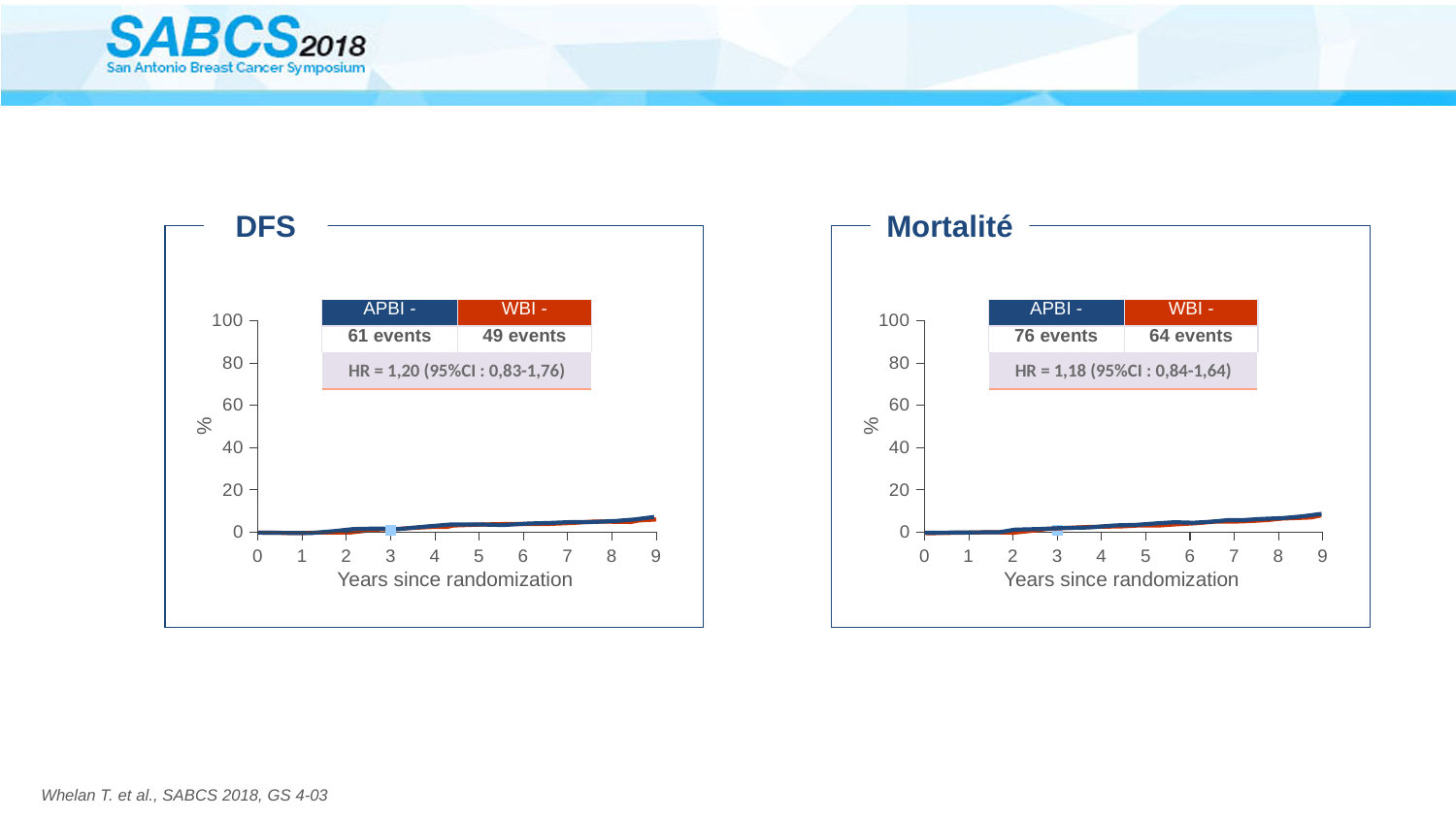
What is the x-axis label of the DFS chart? Years since randomization How many year ticks are shown on the x axis of the DFS chart? 10 In the DFS chart, is the value for WBI at year 9 greater or less than 20? less In the Mortalité chart, do the values rise or fall along the x axis from year 0 to year 9? rise In the Mortalité chart, is the value for APBI at year 9 greater or less than 20? less How many series does the legend of the DFS chart list? 2 What kind of chart is the DFS chart? line chart How many events does the Mortalité chart report for WBI? 64 events In the DFS chart, do the values rise or fall along the x axis from year 0 to year 9? rise What is the title of the chart on the right of the slide? Mortalité How many series does the legend of the Mortalité chart list? 2 How many events does the DFS chart report for APBI? 61 events